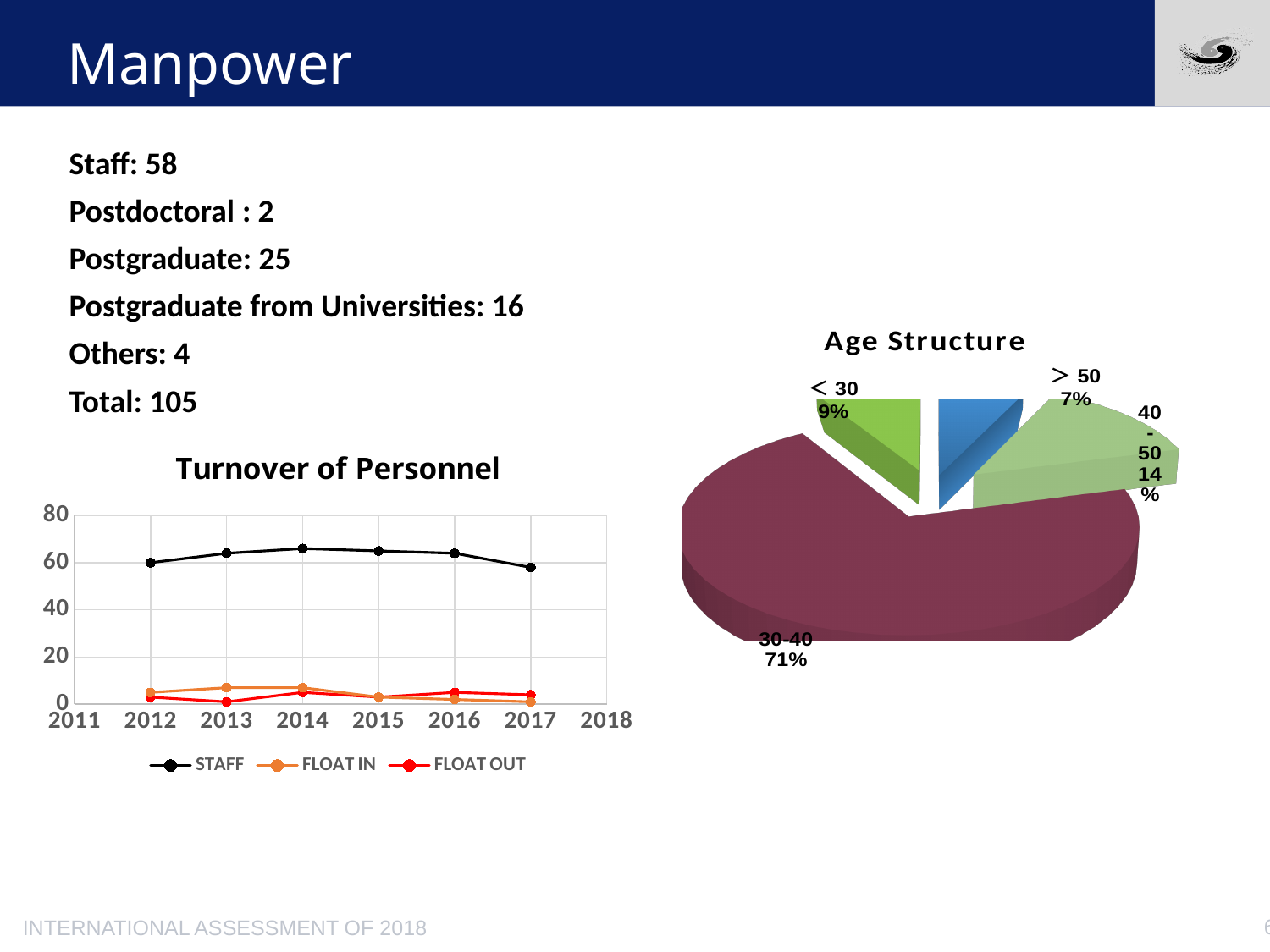
In the Age Structure chart, which is larger, the share for < 30 or the share for > 50? < 30 In the Turnover of Personnel chart, which series has the highest values across all years? STAFF In the Turnover of Personnel chart, is the STAFF value for 2014 greater or less than 60? greater In the Age Structure chart, which age group has the largest share? 30-40 In the Age Structure chart, what percentage is shown for the 40-50 age group? 14% In the Age Structure chart, which age group has the smallest share? > 50 How many series does the legend of the Turnover of Personnel chart list? 3 In the Age Structure chart, what percentage is shown for the < 30 age group? 9% How many age groups are shown in the Age Structure chart? 4 In the Age Structure chart, how many percentage points larger is the 30-40 share than the 40-50 share? 57 What kind of chart is the Age Structure chart? Pie chart In the Age Structure chart, what share of the pie is the 30-40 age group? 71%